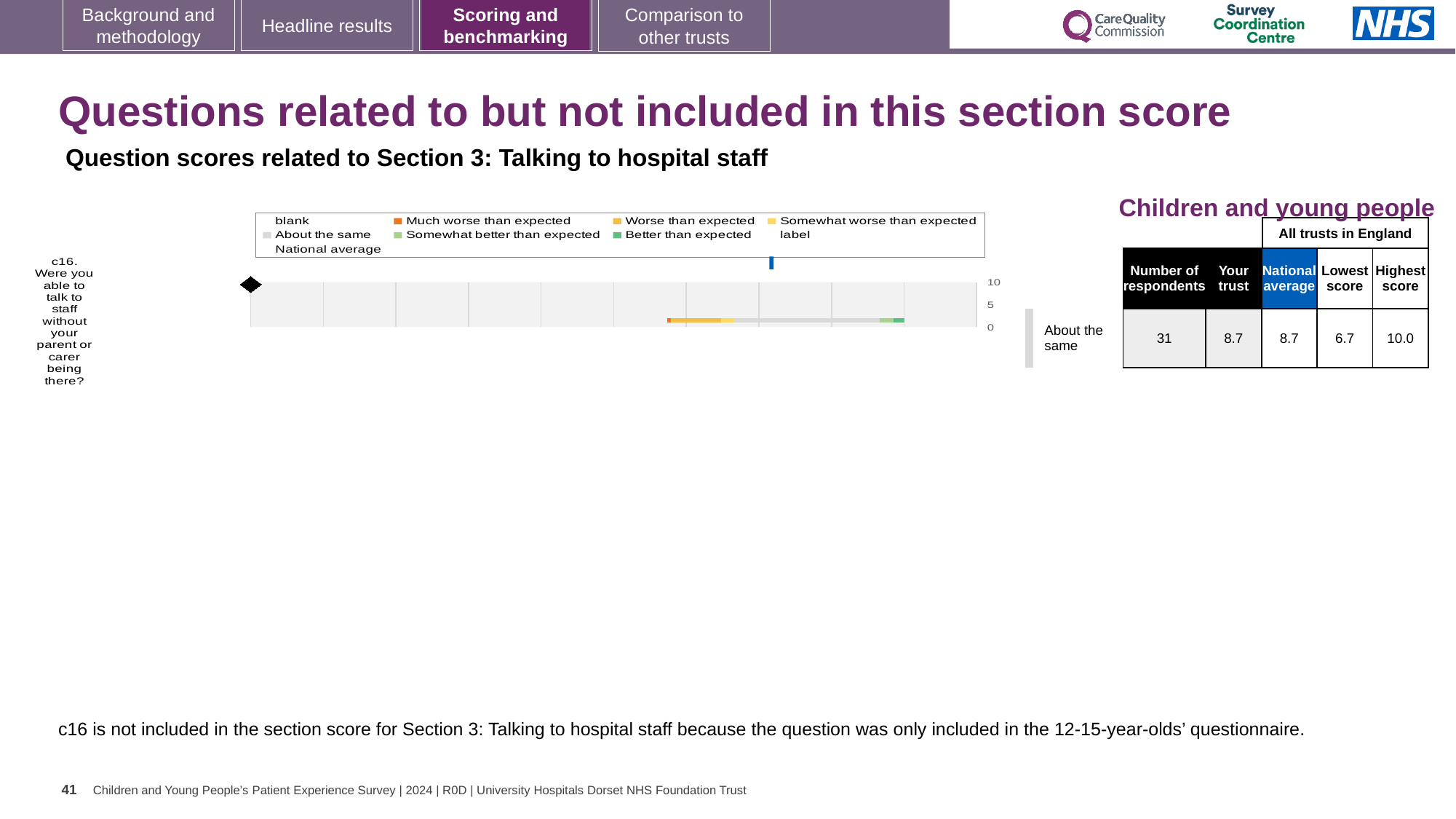
What kind of chart is shown for question c16? bar chart Is the 'Your trust' score for c16 greater or less than 5? greater What is the highest score among all trusts in England for c16? 10.0 What is the 'Your trust' score for c16 in the table beside the chart? 8.7 What is the highest tick value shown on the chart's score axis? 10 How many respondents answered c16 for this trust? 31 Which question code is plotted in the chart? c16 What is the lowest score among all trusts in England for c16? 6.7 What benchmark category is shown next to the c16 bar? About the same How many survey questions are plotted in the chart? 1 What is the national average score for c16 in the table beside the chart? 8.7 What is the difference between the highest score and the lowest score for c16 across all trusts in England? 3.3